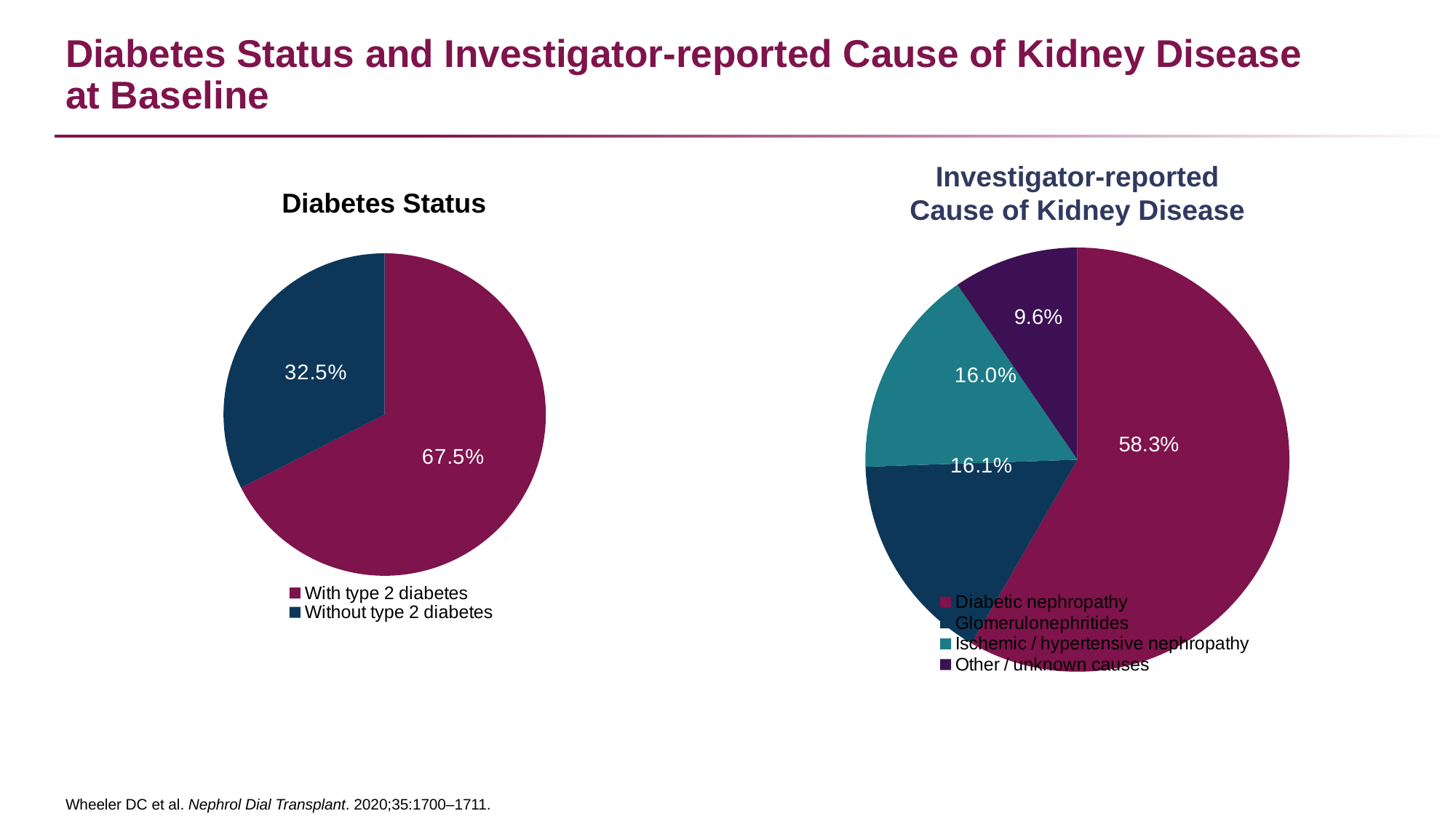
What type of chart is the Diabetes Status chart? Pie chart In the Investigator-reported Cause of Kidney Disease chart, what share is Other / unknown causes? 9.6% In the Investigator-reported Cause of Kidney Disease chart, which cause has the largest share? Diabetic nephropathy In the Investigator-reported Cause of Kidney Disease chart, what share is Glomerulonephritides? 16.1% In the Investigator-reported Cause of Kidney Disease chart, what is the difference between Diabetic nephropathy and Other / unknown causes? 48.7% In the Diabetes Status chart, what is the difference in percentage points between patients with and without type 2 diabetes? 35.0% In the Investigator-reported Cause of Kidney Disease chart, how many categories does the legend list? 4 In the Diabetes Status chart, what percentage of patients are without type 2 diabetes? 32.5% In the Investigator-reported Cause of Kidney Disease chart, which cause has the smallest share? Other / unknown causes In the Investigator-reported Cause of Kidney Disease chart, what share is Diabetic nephropathy? 58.3% In the Diabetes Status chart, what percentage of patients have type 2 diabetes? 67.5% In the Investigator-reported Cause of Kidney Disease chart, what share is Ischemic / hypertensive nephropathy? 16.0%